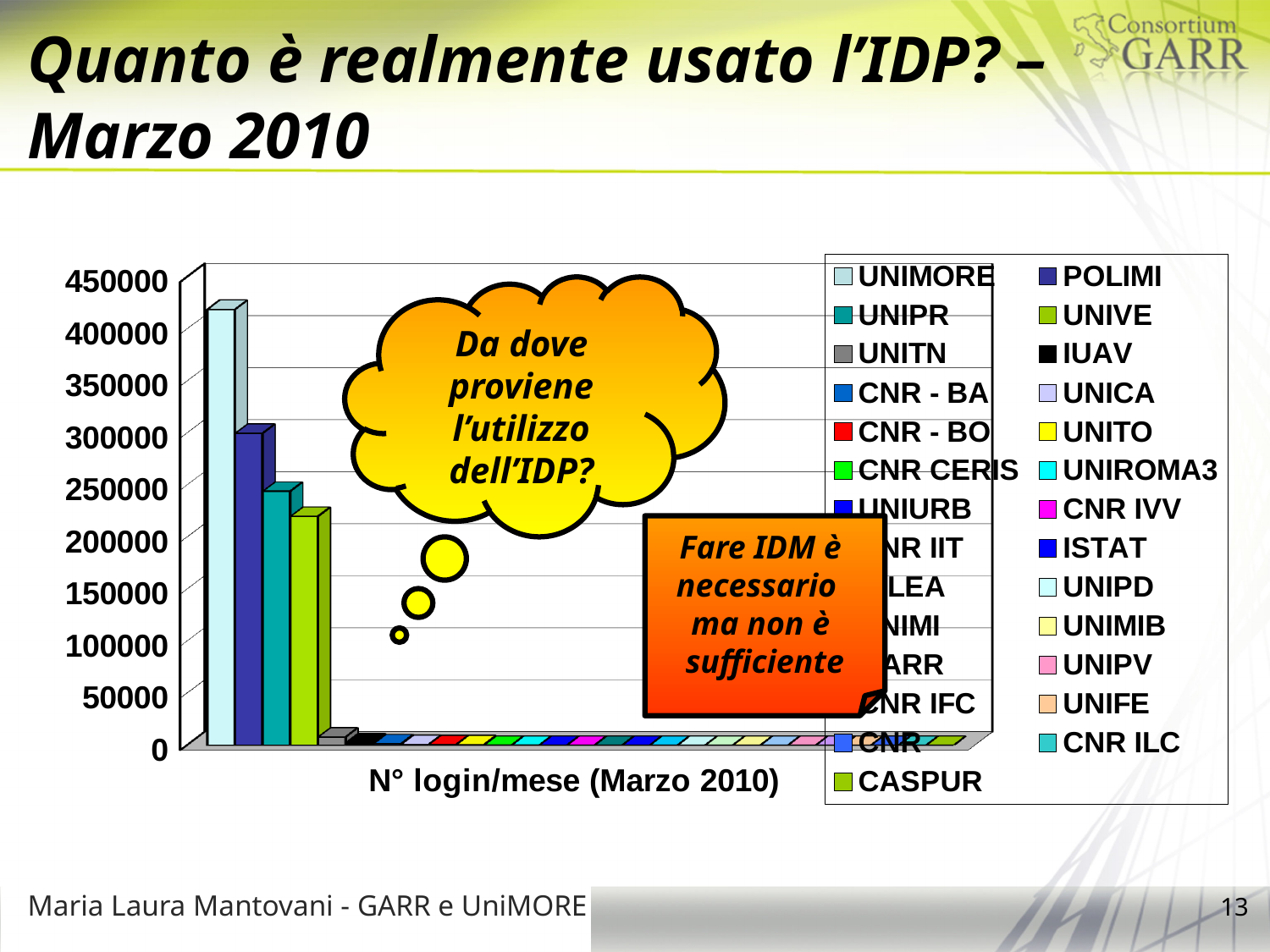
Which is larger, the value for POLIMI or the value for UNIPR? POLIMI Which series has the second highest bar in the chart? POLIMI What kind of chart is shown on the slide? bar chart Is the value for POLIMI greater or less than 350000? less Which is larger, the value for UNIMORE or the value for POLIMI? UNIMORE Which series has the highest number of logins per month in the chart? UNIMORE Is the value for UNIMORE greater or less than 400000? greater Is the value for UNIVE greater or less than 250000? less What is the highest value shown on the y axis of the chart? 450000 What is the label shown below the x axis of the chart? N° login/mese (Marzo 2010)